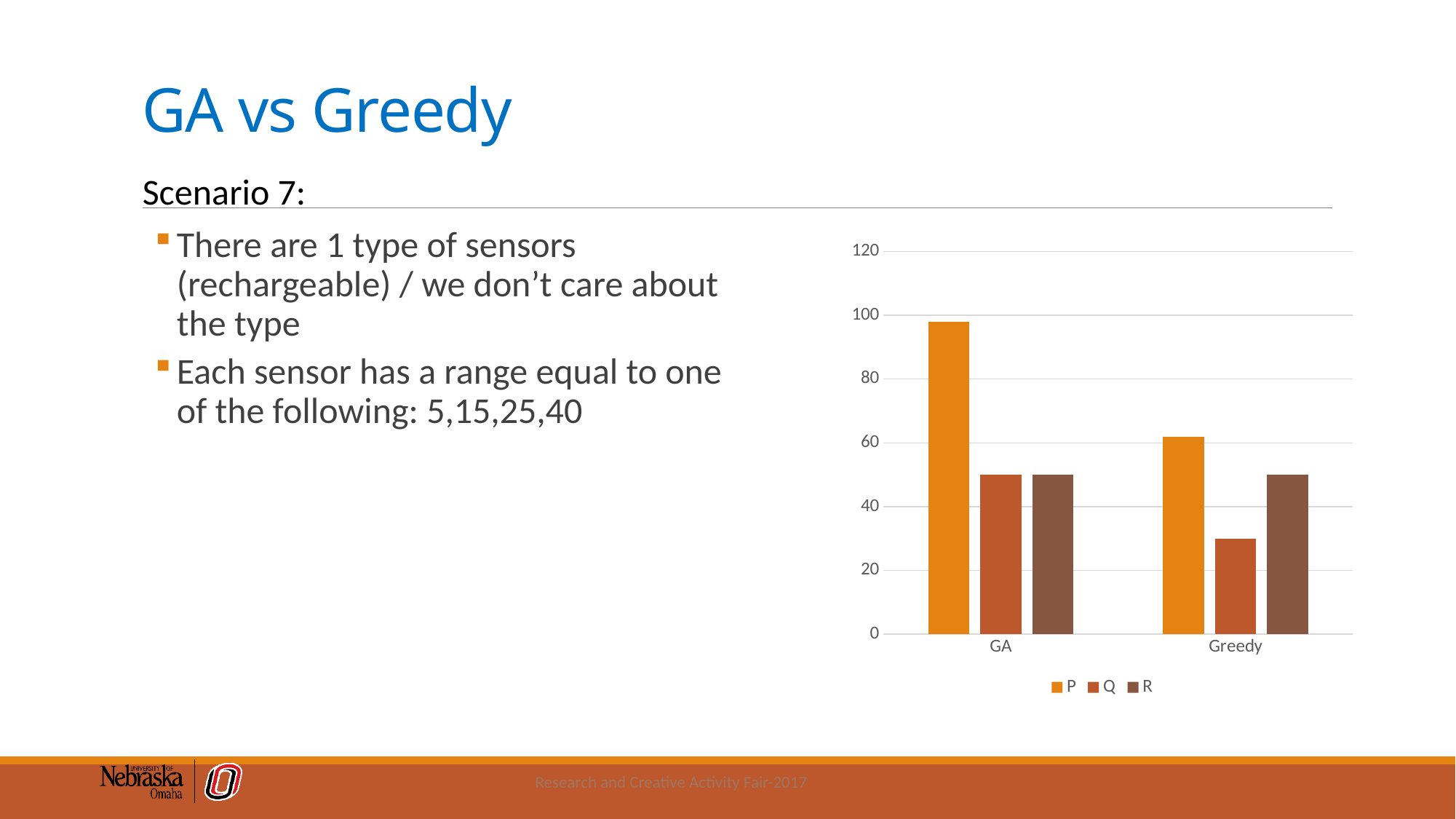
Which series has the highest value for GA? P How many series does the chart's legend list? 3 Is the value of R for GA greater or less than 40? greater How many categories are shown on the x axis of the chart? 2 What kind of chart is shown on the slide? bar chart What are the entries listed in the chart's legend? P, Q, R Is the value of Q larger for GA or for Greedy? GA Which series has the lowest value for Greedy? Q Is the value of P for Greedy greater or less than 80? less Is the value of P larger for GA or for Greedy? GA Is the value of Q for Greedy greater or less than 40? less